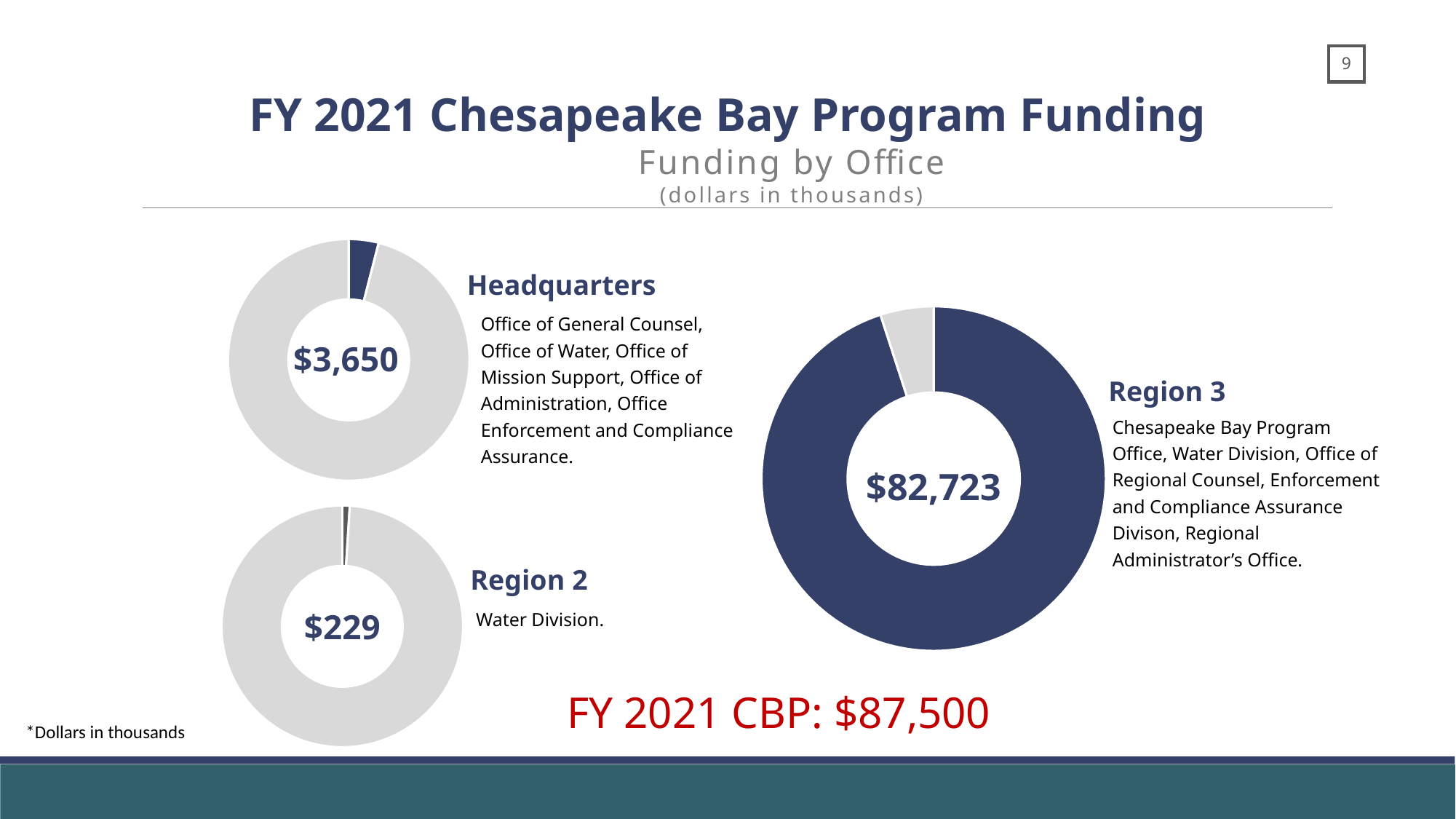
Which is larger, the funding for Headquarters or the funding for Region 2? Headquarters How many donut charts are shown on the slide? 3 What funding value is shown in the Headquarters donut chart? $3,650 What funding value is shown in the Region 2 donut chart? $229 What is the difference between the Headquarters funding and the Region 2 funding? $3,421 What kind of charts are used on this slide to show funding by office? Donut (pie) charts What is the difference between the Region 3 funding and the Headquarters funding? $79,073 Which office has the highest funding among the three donut charts? Region 3 In what units are the dollar values on the slide expressed? Dollars in thousands Which office has the lowest funding among the three donut charts? Region 2 What total FY 2021 CBP funding figure is printed in red on the slide? $87,500 What funding value is shown in the Region 3 donut chart? $82,723